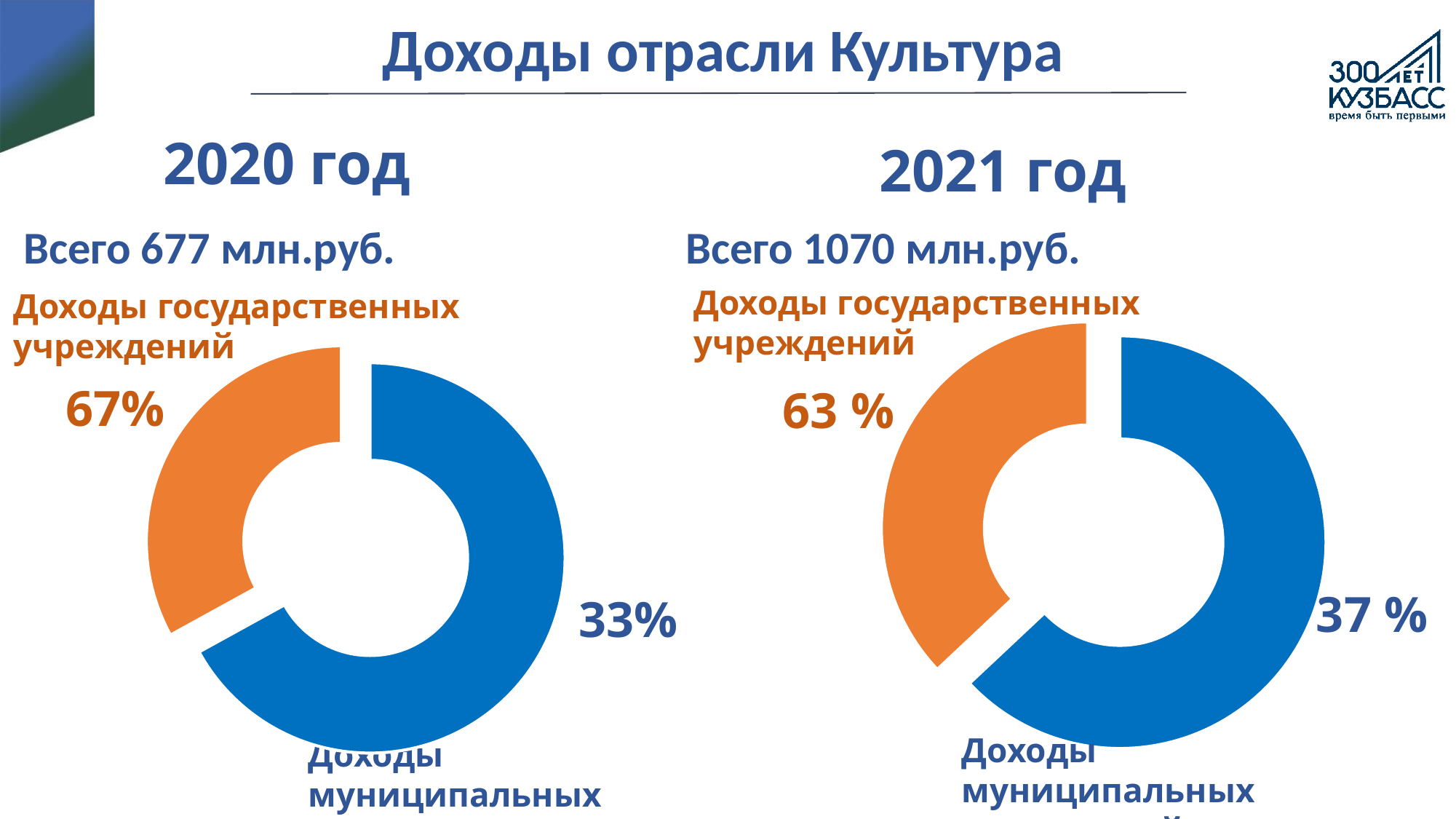
What is the difference between the stated totals for 2021 год and 2020 год? 393 млн.руб. How many slices does the 2021 год chart have? 2 By how many percentage points did the labelled share of Доходы государственных учреждений change from the 2020 год chart to the 2021 год chart? 4 percentage points (67% to 63 %) What total amount is stated for 2021 год? 1070 млн.руб. In the 2021 год chart, what share is shown for Доходы государственных учреждений? 63 % What is the title of the slide containing the two charts? Доходы отрасли Культура What total amount is stated for 2020 год? 677 млн.руб. In the 2020 год chart, what share is shown for Доходы государственных учреждений? 67% In the 2020 год chart, which colour represents Доходы государственных учреждений? Orange In the 2020 год chart, what share is shown for Доходы муниципальных учреждений? 33% In the 2021 год chart, what share is shown for Доходы муниципальных учреждений? 37 % What type of chart is used for the 2020 год data? Pie (donut) chart